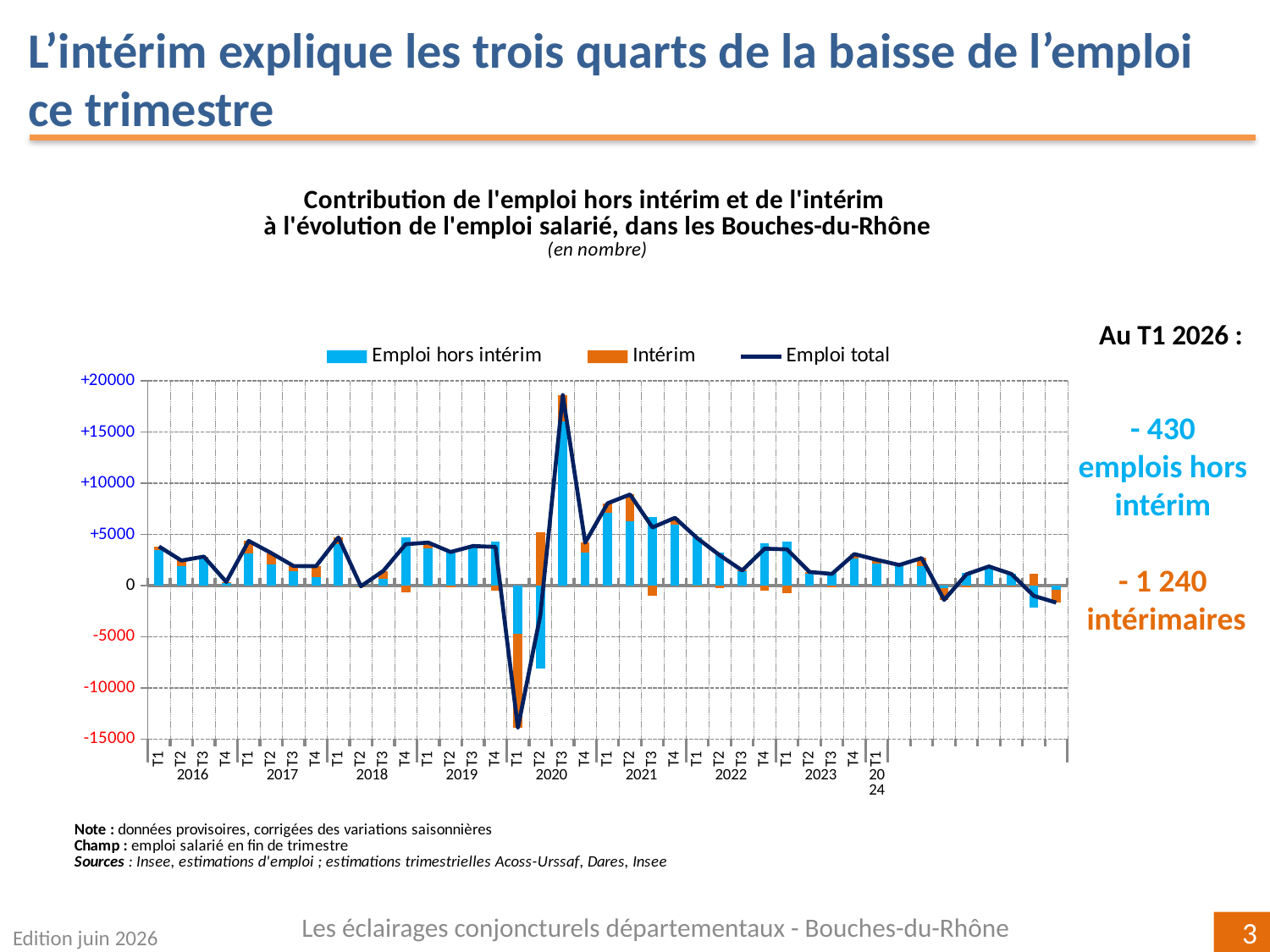
What kind of chart is this? Combined bar and line chart According to the annotation on the right, what is the change in intérimaires at T1 2026? - 1 240 How many series does the legend list? 3 Is the value of Emploi hors intérim at T1 2016 greater or less than +5000? less In which quarter does the Emploi total line reach its lowest point? T1 2020 Is the value of Emploi total at T2 2021 greater or less than +5000? greater Which series is drawn as a line rather than bars? Emploi total Is the value of Emploi total at T3 2020 greater or less than +15000? greater What colour are the Intérim bars? Orange In which quarter does the Emploi total line reach its highest point? T3 2020 According to the annotation on the right, what is the change in emplois hors intérim at T1 2026? - 430